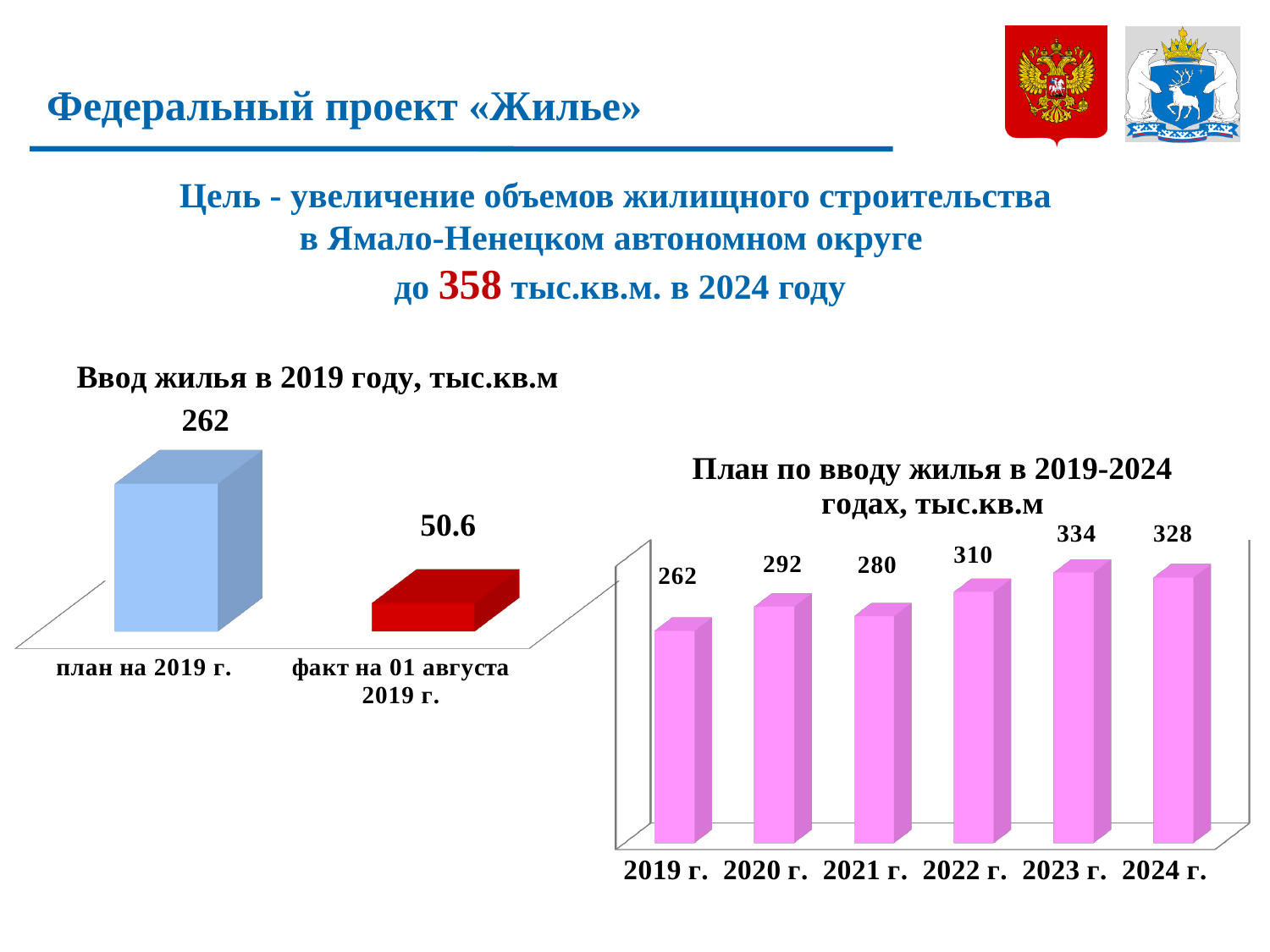
In the chart 'План по вводу жилья в 2019-2024 годах, тыс.кв.м', what is the difference between the values for 2023 г. and 2019 г.? 72 In the chart 'План по вводу жилья в 2019-2024 годах, тыс.кв.м', which year has the lowest value? 2019 г. In the chart 'Ввод жилья в 2019 году, тыс.кв.м', what is the difference between the plan for 2019 and the fact as of 01 August 2019? 211.4 In the chart 'План по вводу жилья в 2019-2024 годах, тыс.кв.м', what is the value for 2022 г.? 310 What type of chart is 'План по вводу жилья в 2019-2024 годах, тыс.кв.м'? Bar chart In the chart 'План по вводу жилья в 2019-2024 годах, тыс.кв.м', which year has the highest value? 2023 г. In the chart 'План по вводу жилья в 2019-2024 годах, тыс.кв.м', which is larger, the value for 2020 г. or 2021 г.? 2020 г. In the chart 'План по вводу жилья в 2019-2024 годах, тыс.кв.м', how many years are shown? 6 In the chart 'Ввод жилья в 2019 году, тыс.кв.м', what is the value for 'план на 2019 г.'? 262 In the chart 'Ввод жилья в 2019 году, тыс.кв.м', what is the value for 'факт на 01 августа 2019 г.'? 50.6 In the chart 'План по вводу жилья в 2019-2024 годах, тыс.кв.м', what is the value for 2024 г.? 328 In the chart 'Ввод жилья в 2019 году, тыс.кв.м', how many categories are shown? 2